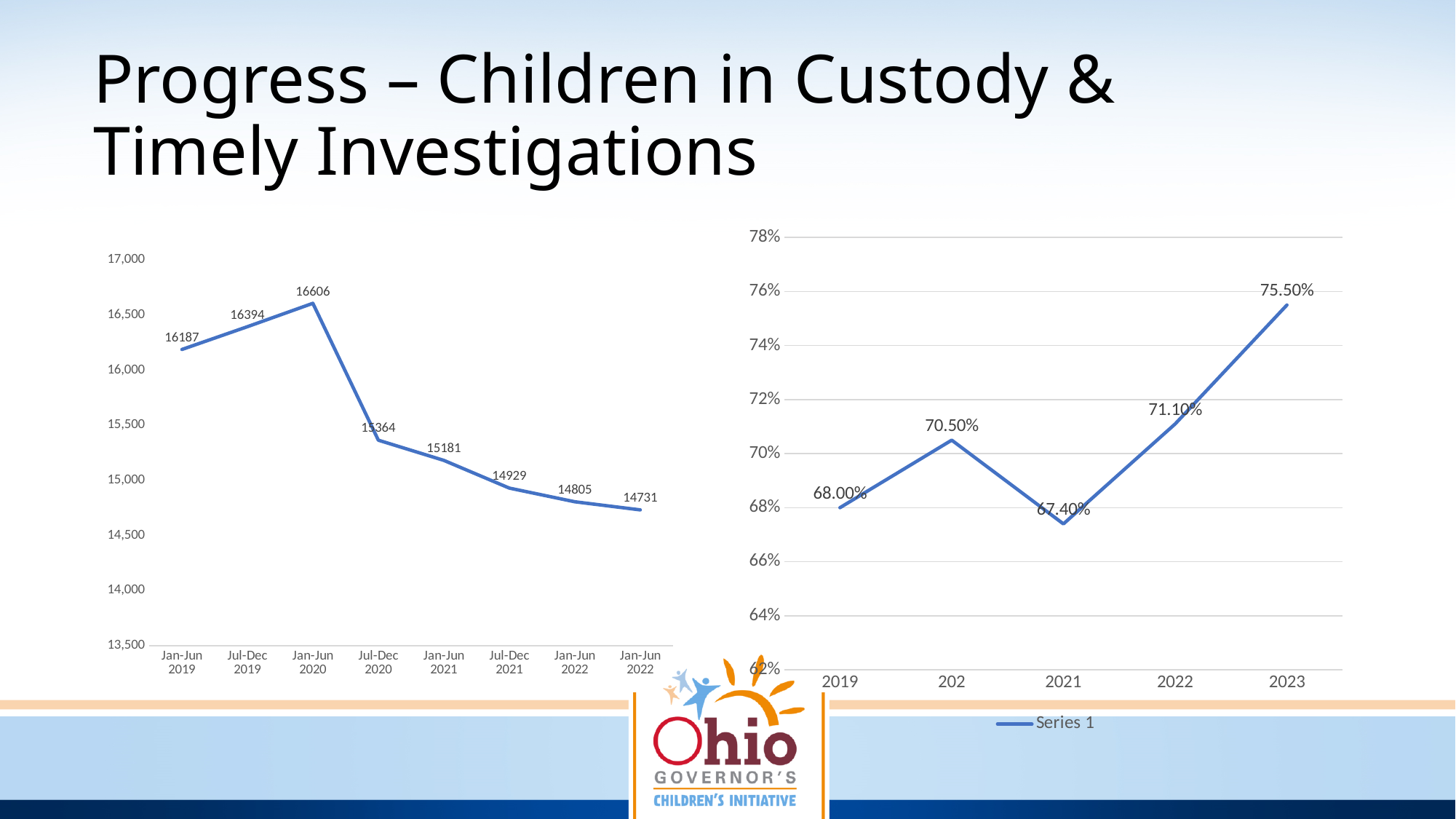
On the right chart, what is the difference between the values for 2023 and 2022? 4.40% On the right chart, what is the name of the series shown in the legend? Series 1 On the left chart, what type of chart is shown? Line chart On the left chart, what is the difference between the values for Jan-Jun 2020 and Jul-Dec 2020? 1242 On the right chart, which year has the lowest value? 2021 On the left chart, what is the value for Jul-Dec 2020? 15364 On the left chart, what is the value for Jan-Jun 2020? 16606 On the left chart, how many data points are plotted? 8 On the left chart, which period has the highest value? Jan-Jun 2020 On the left chart, what is the value of the last data point? 14731 On the right chart, what is the value for 2023? 75.50% On the right chart, is the value for 2019 greater or less than 70%? less